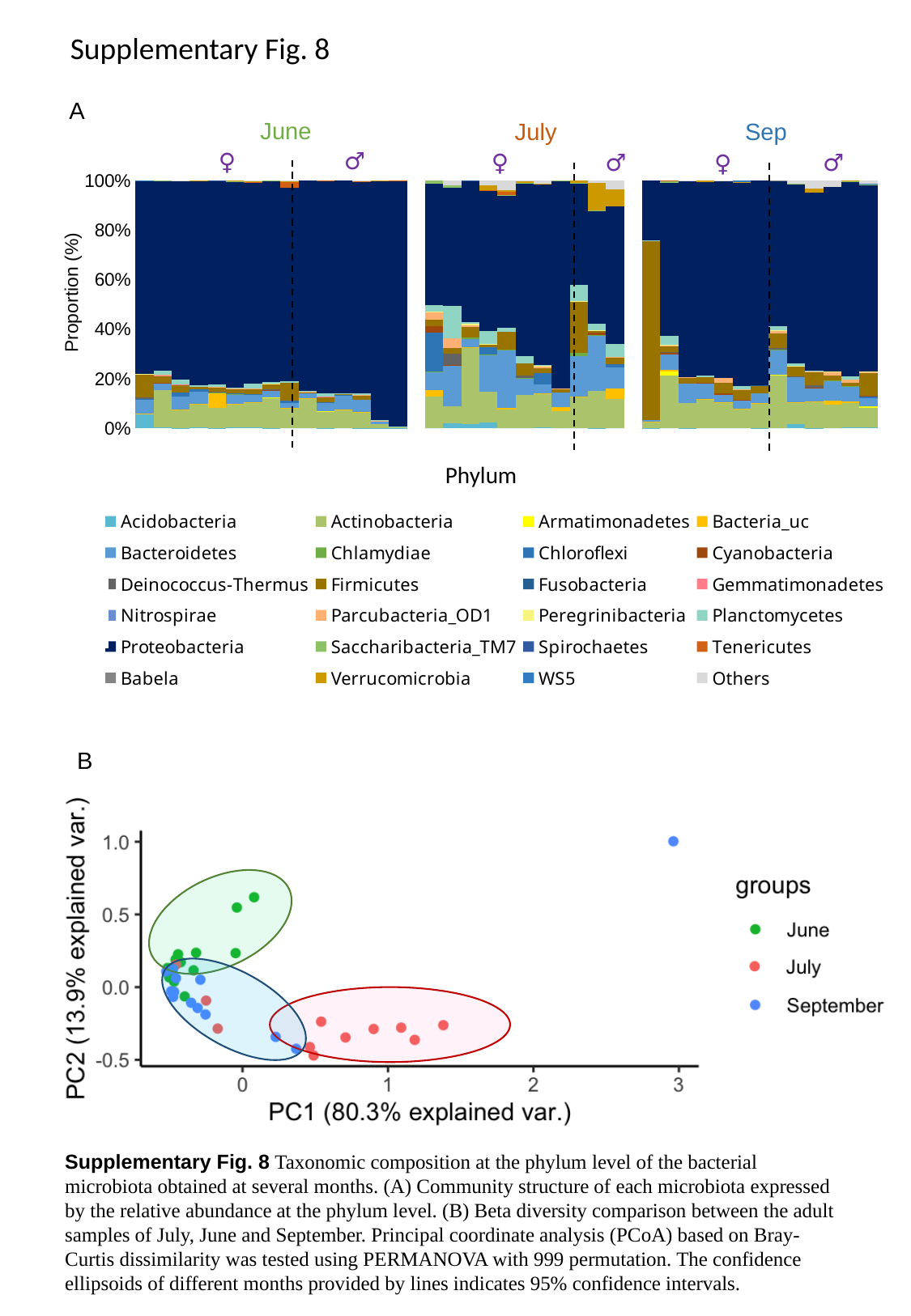
What kind of chart is panel A (the top chart)? Stacked bar chart In panel A, is the proportion of Proteobacteria in the June samples greater or less than 60%? greater In panel A, is the proportion of Firmicutes in the first (leftmost) Sep sample greater or less than 60%? greater In panel A, how many months (panels) are shown along the x axis? 3 What kind of chart is panel B (the bottom chart)? Scatter plot In panel A, is the proportion of Actinobacteria in the June samples greater or less than 40%? less In panel B, which group does the isolated point near PC1 = 3 and PC2 = 1.0 belong to? September In panel B, how many groups does the legend list? 3 In panel A, what is the label of the y axis? Proportion (%) In panel A, which phylum makes up the largest share of the June samples? Proteobacteria In panel B, what percentage of variance does PC1 explain according to the x-axis label? 80.3% In panel A, how many phyla (including Others) does the legend list? 24